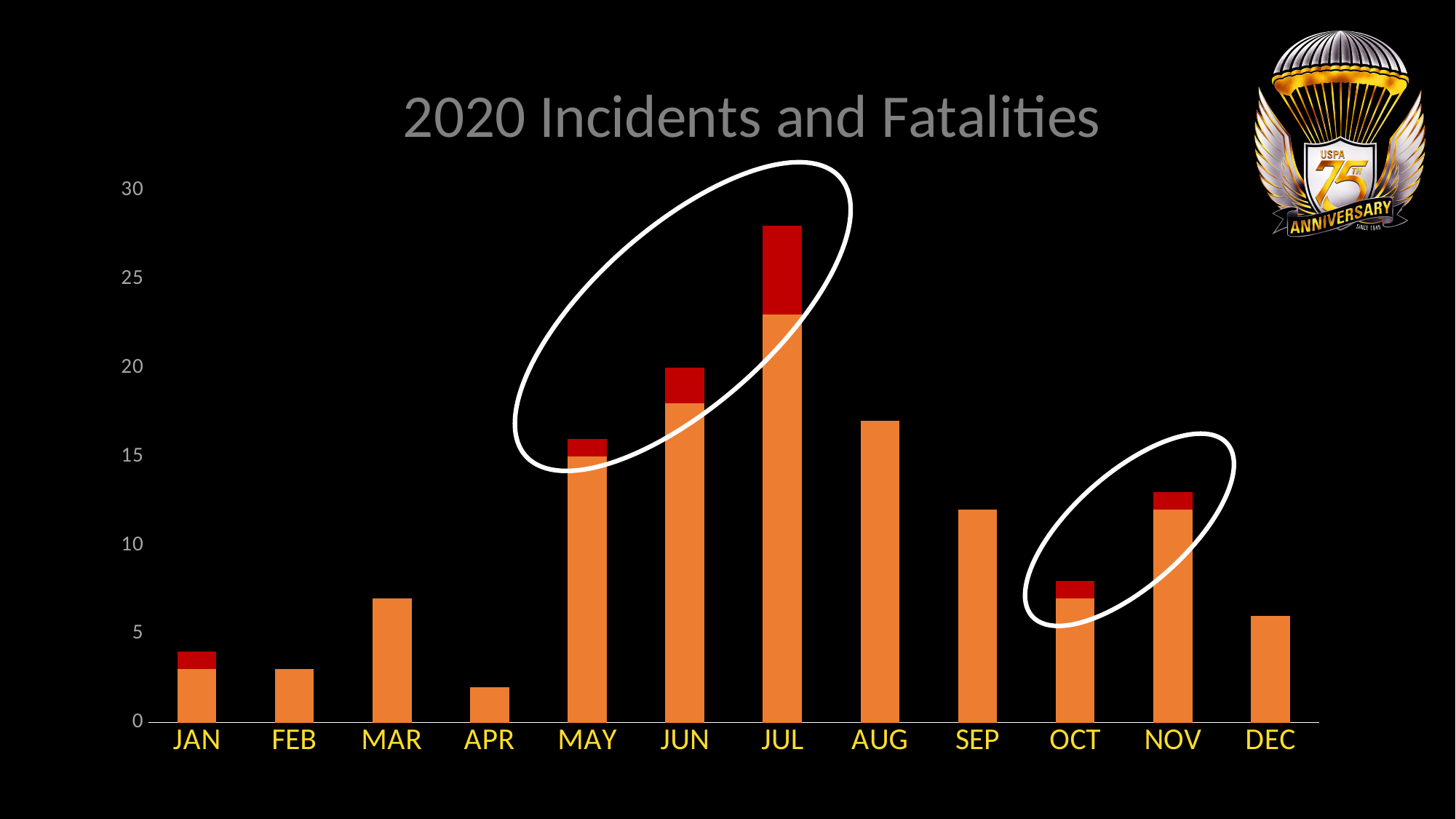
What two colours are used for the bar segments in the chart? orange and red What kind of chart is shown on the slide? bar chart Is the value for APR greater or less than 5? less How many months are shown on the x axis of the chart? 12 Which month has the tallest bar in the chart? JUL Is the total value for OCT greater or less than 10? less What is the title of the chart? 2020 Incidents and Fatalities Is the total value for JUL greater or less than 25? greater Do the bar heights rise or fall from MAY to JUL? rise Which bar is taller, AUG or SEP? AUG